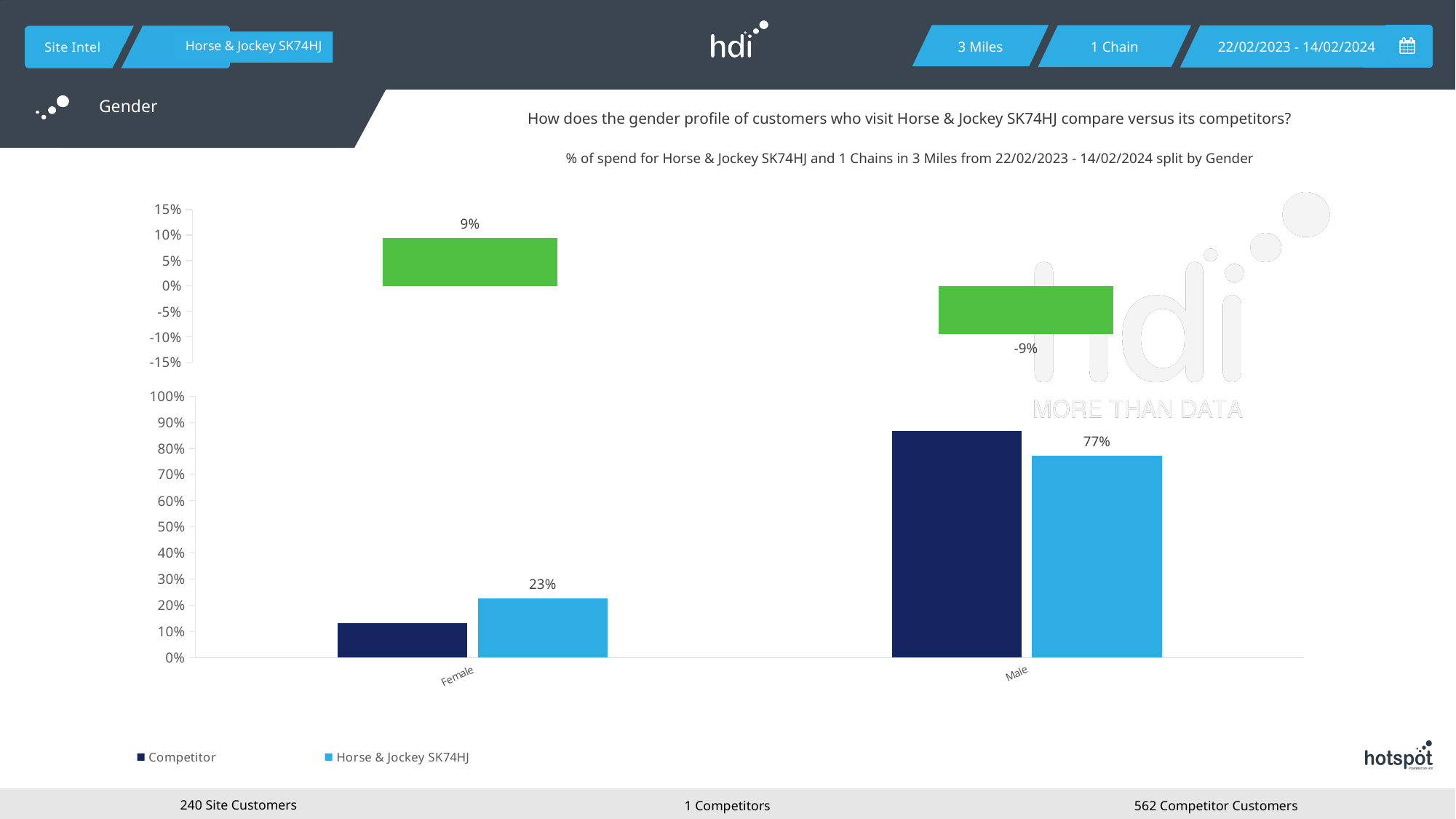
In the bottom bar chart, is the Competitor value for Female greater or less than 20%? less How many series does the legend of the bottom chart list? 2 In the top chart, what is the value shown for Female? 9% In the bottom bar chart, what is the value for Horse & Jockey SK74HJ for Male? 77% In the top chart, what is the value shown for Male? -9% In the bottom bar chart, for Male, which is larger: Competitor or Horse & Jockey SK74HJ? Competitor In the bottom bar chart, for Female, which is larger: Competitor or Horse & Jockey SK74HJ? Horse & Jockey SK74HJ In the bottom bar chart, which gender has the higher value for Horse & Jockey SK74HJ? Male In the bottom bar chart, what is the value for Horse & Jockey SK74HJ for Female? 23% In the bottom bar chart, is the Competitor value for Male greater or less than 80%? greater In the bottom bar chart, what is the difference between the Horse & Jockey SK74HJ values for Male and Female? 54% What type of chart is the bottom chart? Bar chart